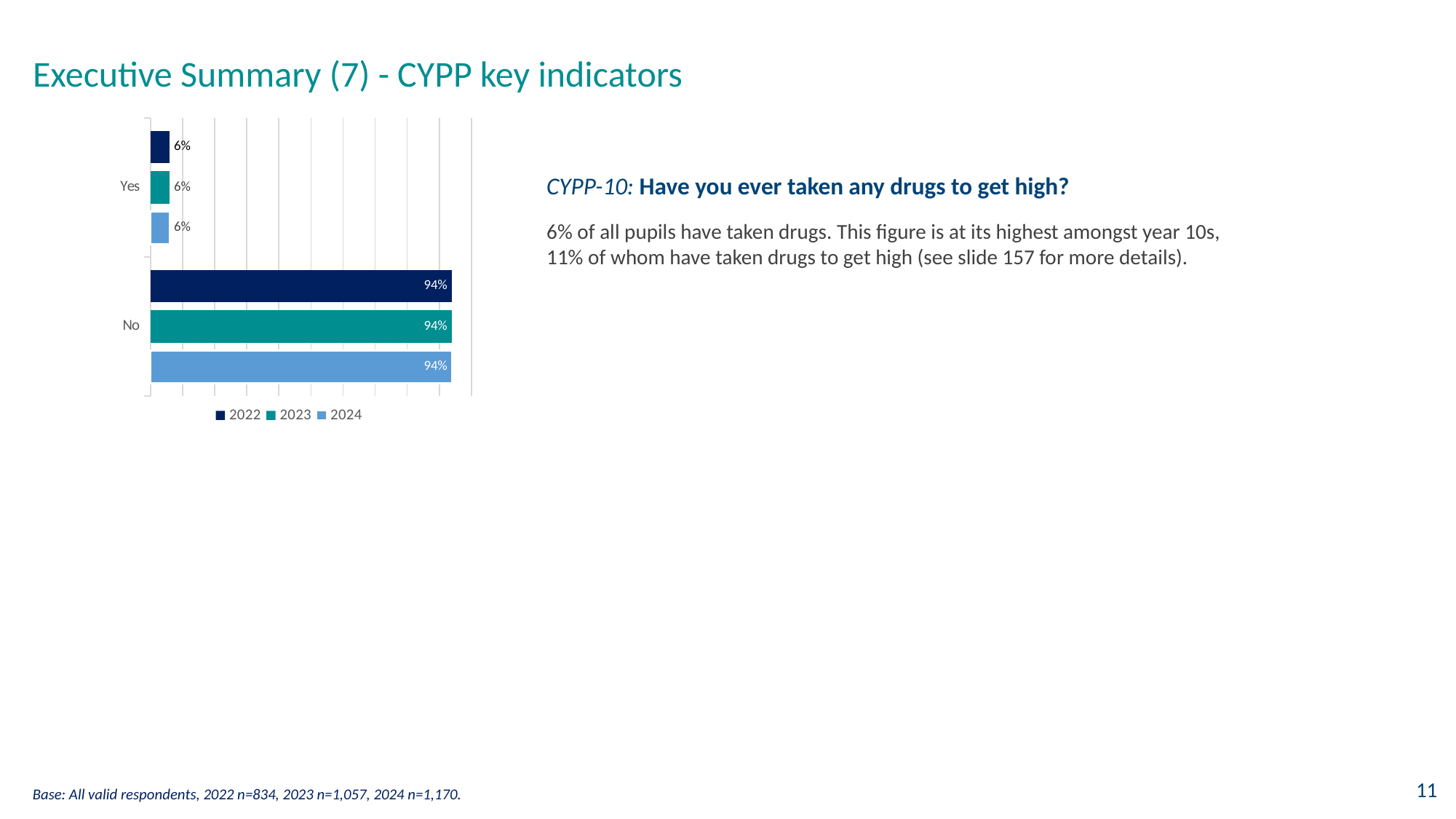
Which category has the higher value in 2024, 'Yes' or 'No'? No Which years are listed in the chart legend? 2022, 2023, 2024 What kind of chart is shown on the slide? Bar chart What is the value for 'No' in 2023? 94% What is the value for 'Yes' in 2022? 6% What is the total of the 'Yes' and 'No' values for 2022? 100% What percentage of pupils answered 'Yes' in 2024? 6% What percentage of pupils answered 'No' in 2022? 94% Did the 'Yes' value change between 2022 and 2024? No, it stayed at 6% How many response categories are shown on the chart? 2 What is the difference between the 'No' and 'Yes' values for 2023? 88% How many series does the legend list? 3